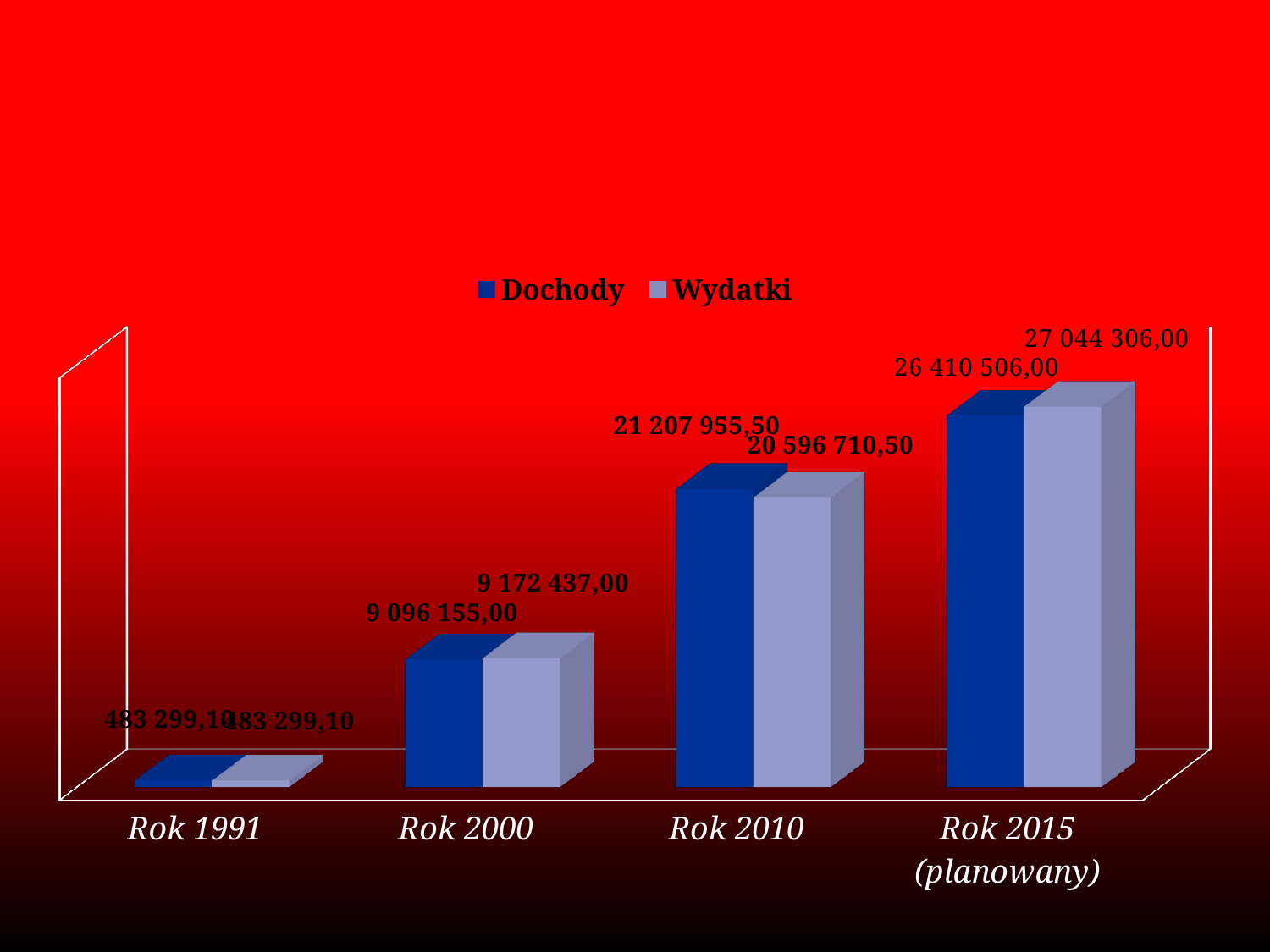
Do the Dochody values rise or fall from Rok 1991 to Rok 2015 (planowany)? rise How many series does the legend list? 2 What type of chart is shown on the slide? bar chart Which year has the highest Dochody value? Rok 2015 (planowany) How many year categories are shown on the x axis? 4 What is the Dochody value for Rok 2000? 9 096 155,00 For Rok 2015 (planowany), which is larger, Dochody or Wydatki? Wydatki What is the Wydatki value for Rok 1991? 483 299,10 What is the Wydatki value for Rok 2015 (planowany)? 27 044 306,00 Which year has the lowest Wydatki value? Rok 1991 What is the difference between Dochody and Wydatki for Rok 2010? 611 245,00 What is the Dochody value for Rok 2010? 21 207 955,50